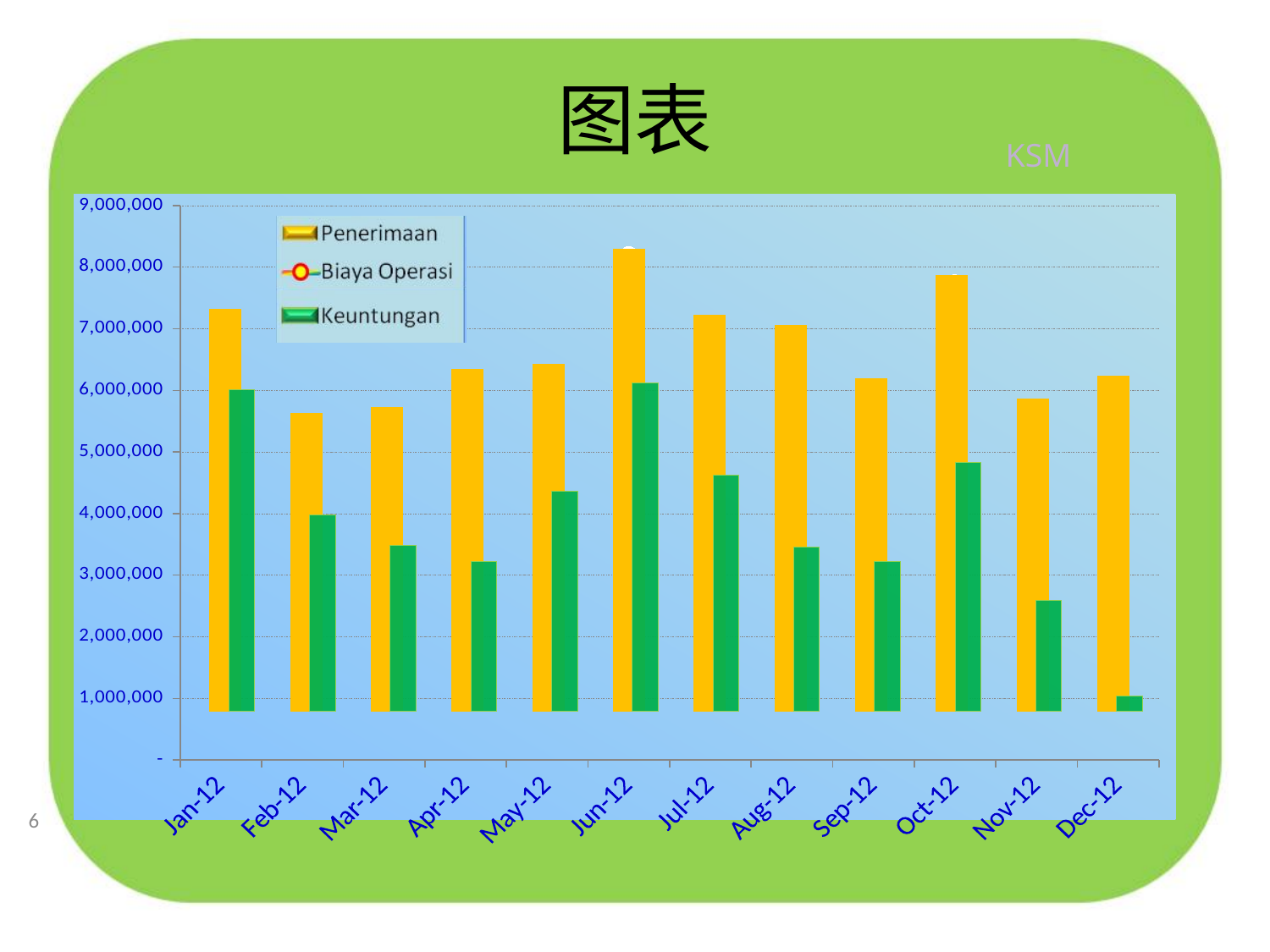
Which month has the highest Penerimaan value? Jun-12 How many months are shown on the x axis of the chart? 12 Is the Keuntungan value for Dec-12 greater or less than 2,000,000? less What kind of chart is shown on the slide? bar chart What are the three series names listed in the chart legend? Penerimaan, Biaya Operasi, Keuntungan Is the Keuntungan value for Nov-12 greater or less than 3,000,000? less Which is larger, the Keuntungan value for Jan-12 or for Nov-12? Jan-12 How many series does the chart legend list? 3 Which is larger, the Penerimaan value for Jun-12 or for Feb-12? Jun-12 Is the Penerimaan value for Jun-12 greater or less than 8,000,000? greater Which month has the lowest Keuntungan value? Dec-12